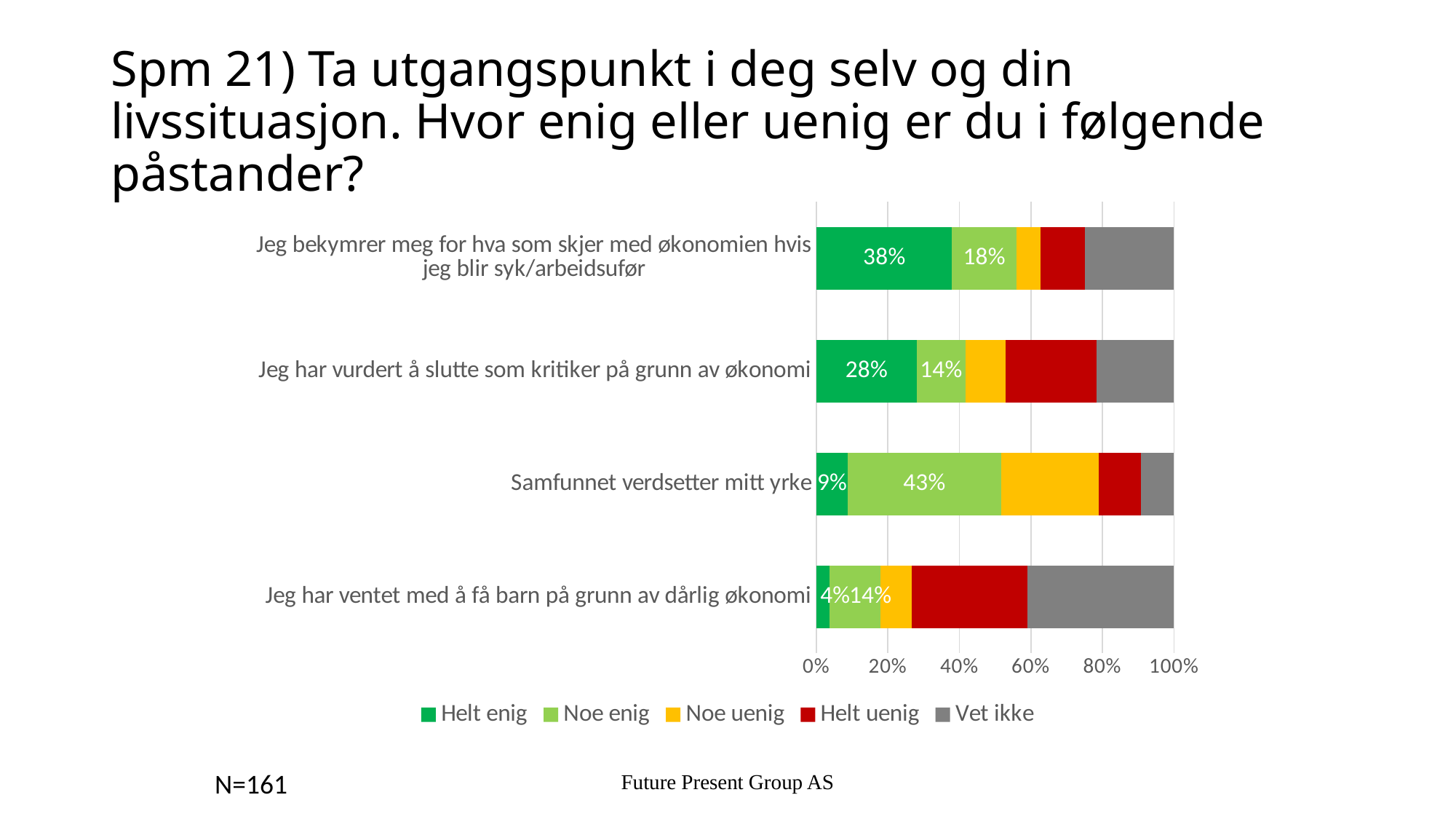
What percentage answered "Helt enig" to "Jeg har ventet med å få barn på grunn av dårlig økonomi"? 4% What percentage answered "Noe enig" to "Jeg har vurdert å slutte som kritiker på grunn av økonomi"? 14% How many response categories does the legend list? 5 Which is larger: the "Noe enig" share for "Samfunnet verdsetter mitt yrke" or for "Jeg bekymrer meg for hva som skjer med økonomien hvis jeg blir syk/arbeidsufør"? Samfunnet verdsetter mitt yrke Which statement has the highest "Helt enig" share? Jeg bekymrer meg for hva som skjer med økonomien hvis jeg blir syk/arbeidsufør Which statement has the lowest "Helt enig" share? Jeg har ventet med å få barn på grunn av dårlig økonomi What percentage answered "Noe enig" to "Samfunnet verdsetter mitt yrke"? 43% What type of chart is shown on the slide? Stacked bar chart How many statements are shown in the chart? 4 What percentage answered "Helt enig" to "Jeg bekymrer meg for hva som skjer med økonomien hvis jeg blir syk/arbeidsufør"? 38% Is the "Vet ikke" share for "Jeg har ventet med å få barn på grunn av dårlig økonomi" greater or less than 20%? greater What is the difference in percentage points between the "Helt enig" shares for "Jeg bekymrer meg for hva som skjer med økonomien hvis jeg blir syk/arbeidsufør" and "Jeg har vurdert å slutte som kritiker på grunn av økonomi"? 10 percentage points